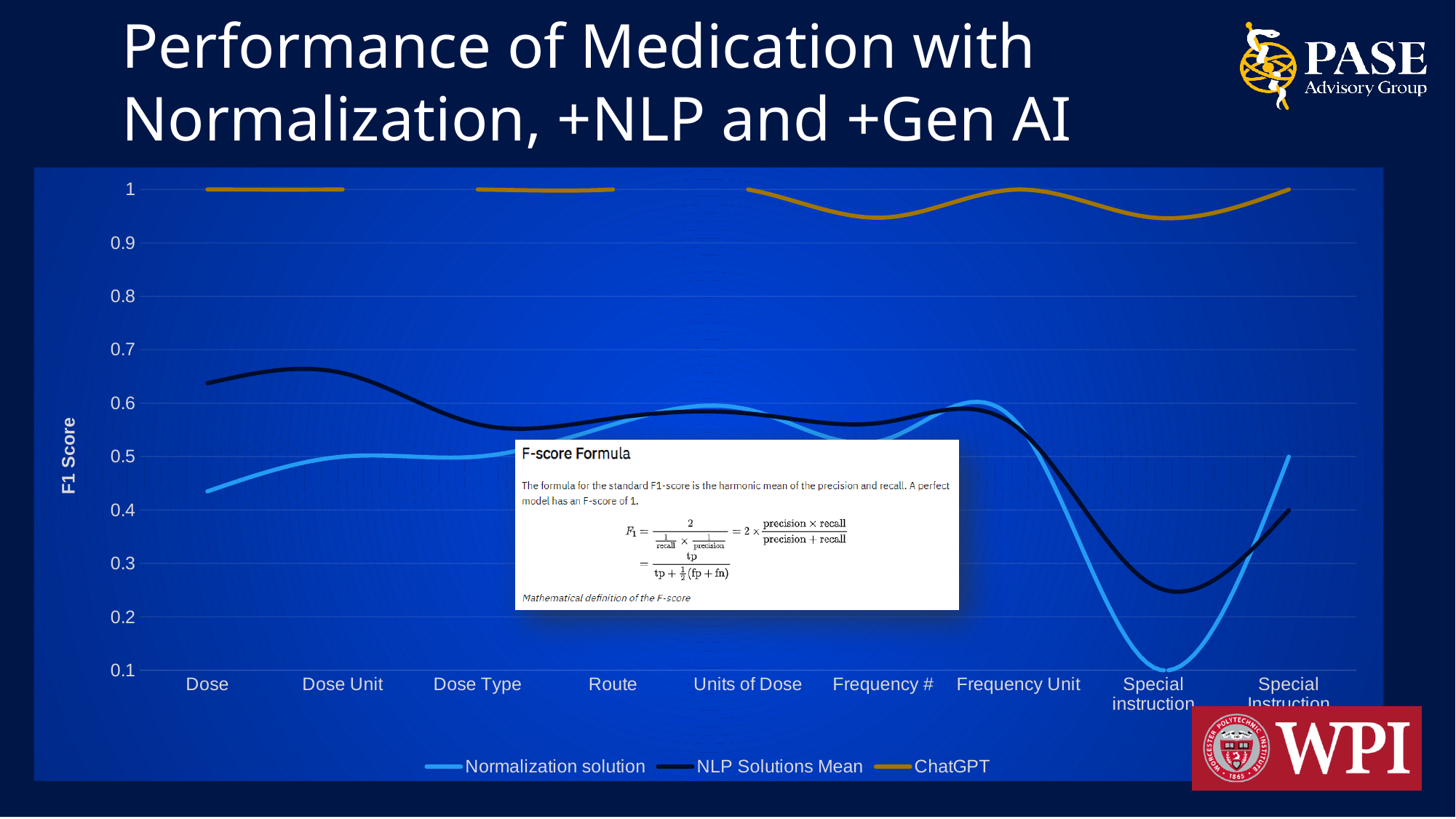
How many categories are shown along the x axis? 9 How many series does the legend list? 3 At Dose, which series has the higher F1 Score: Normalization solution or NLP Solutions Mean? NLP Solutions Mean What is the title of the vertical axis? F1 Score Is the NLP Solutions Mean value for Dose greater or less than 0.6? greater What is the ChatGPT F1 Score for Dose? 1 What kind of chart is shown on the slide? Line chart Is the Normalization solution value for Dose greater or less than 0.5? less Is the NLP Solutions Mean value for Special instruction greater or less than 0.3? less For which category is the Normalization solution F1 Score lowest? Special instruction Which series is drawn in gold/orange? ChatGPT